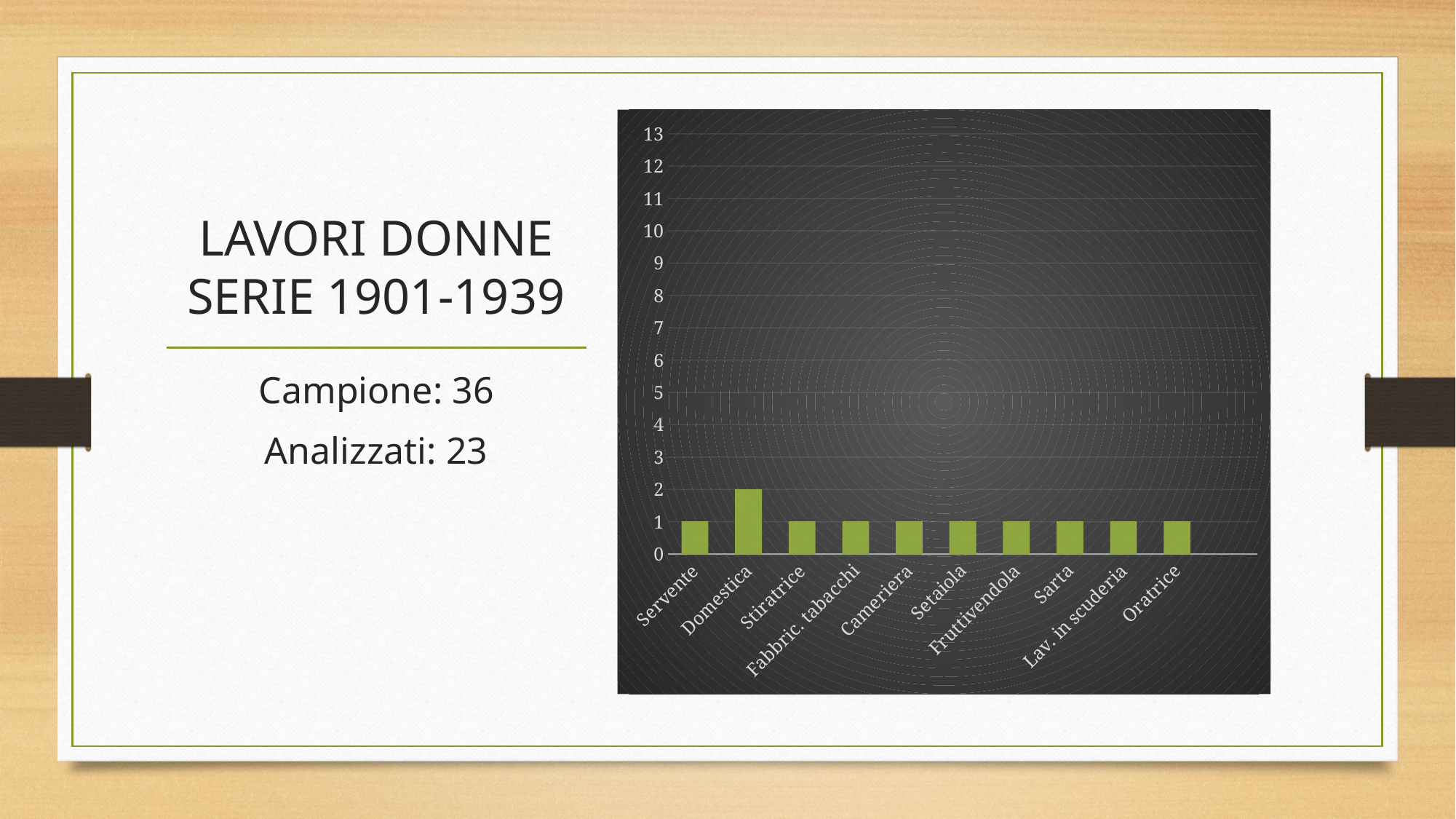
Which is larger, the value for Domestica or the value for Oratrice? Domestica Which category has the highest value? Domestica Is the value for Domestica greater or less than 5? less What is the difference between the values for Domestica and Sarta? 1 What colour are the bars in the chart? green What is the value for Domestica? 2 What kind of chart is shown on the slide? bar chart What is the value for Lav. in scuderia? 1 What is the highest value shown on the y axis? 13 What is the value for Servente? 1 How many categories are shown on the x axis? 10